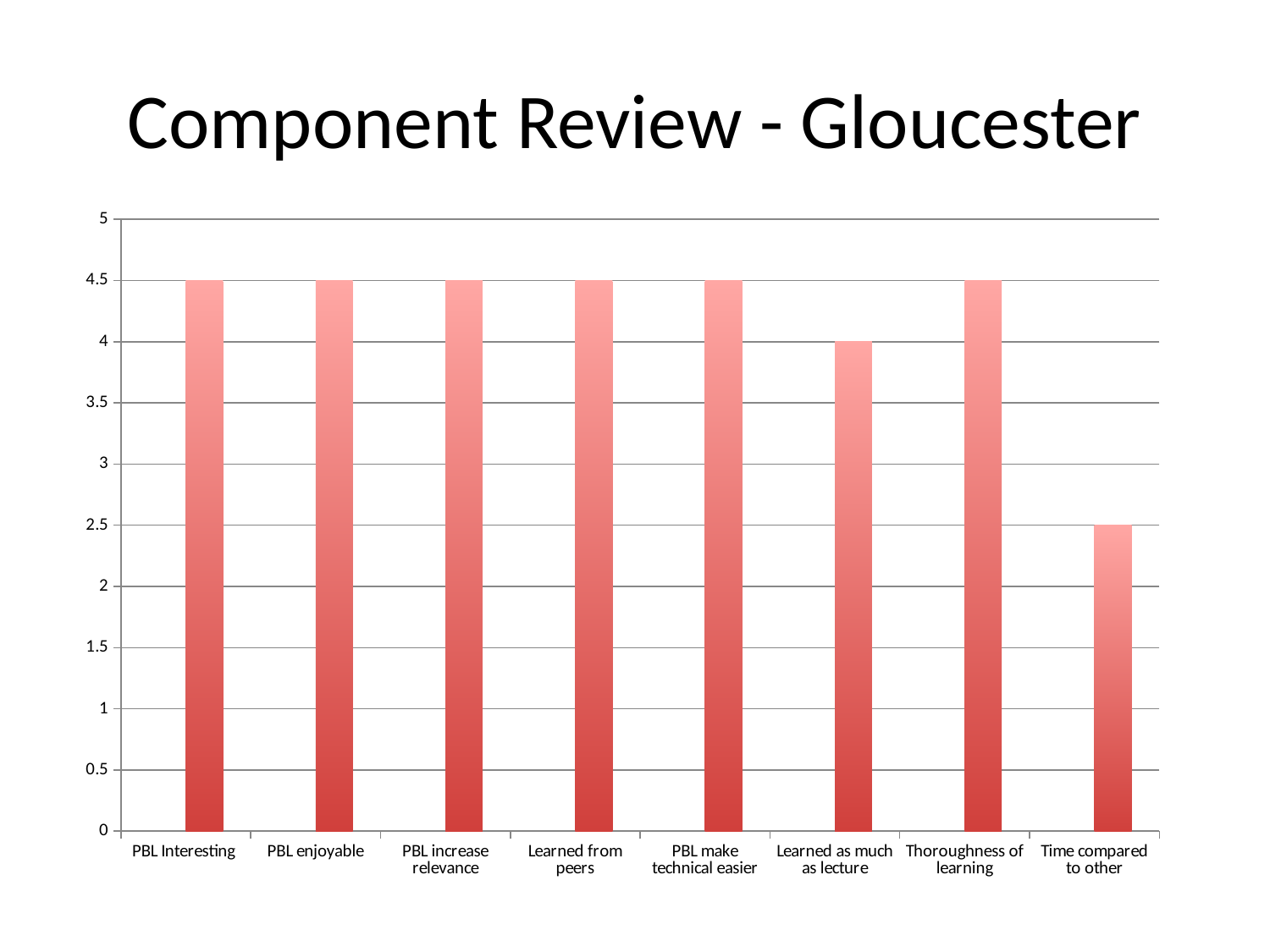
What is the difference between the values for PBL enjoyable and Learned as much as lecture? 0.5 Is the value for Learned as much as lecture greater or less than 3? greater How many categories are shown on the x axis? 8 Which category has the lowest value? Time compared to other What is the title of the slide? Component Review - Gloucester What is the value for Learned as much as lecture? 4 Is the value for Time compared to other greater or less than 3? less What is the value for PBL Interesting? 4.5 What is the value for Time compared to other? 2.5 What is the difference between the values for Learned as much as lecture and Time compared to other? 1.5 Which is larger, the value for Thoroughness of learning or the value for Time compared to other? Thoroughness of learning What kind of chart is shown on the slide? Bar chart